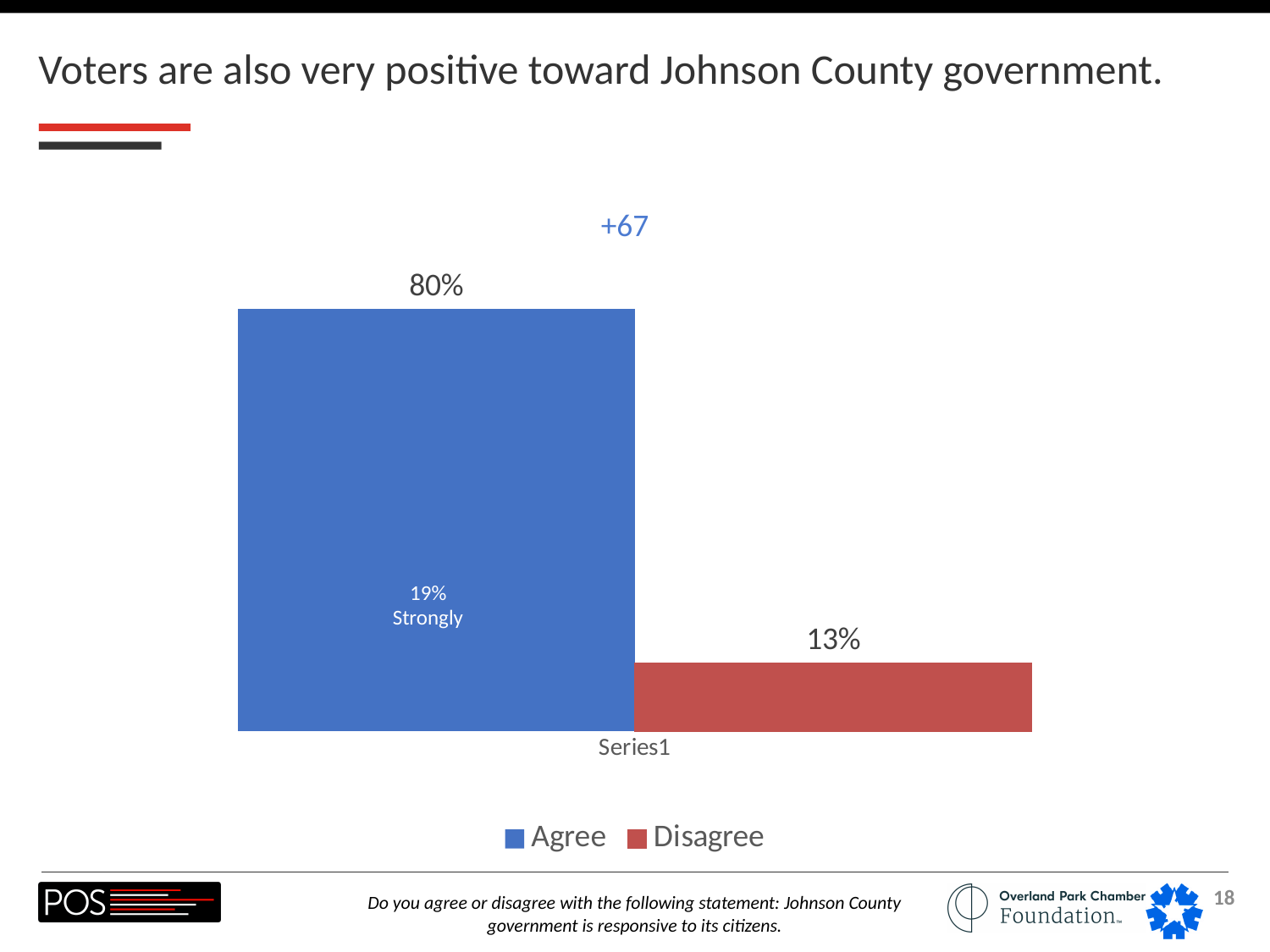
What net figure is printed above the chart? +67 What is the category label shown on the x axis? Series1 Is the value for Agree greater or less than 50%? greater What is the difference between the Agree and Disagree percentages? 67 percentage points What percentage of voters agree that Johnson County government is responsive to its citizens? 80% Which series has the higher value, Agree or Disagree? Agree Which series has the lowest value on the chart? Disagree What percentage of voters strongly agree, as shown inside the Agree bar? 19% How many series does the legend list? 2 What kind of chart is shown on the slide? Bar chart What colour is the Disagree bar? Red What percentage of voters disagree that Johnson County government is responsive to its citizens? 13%